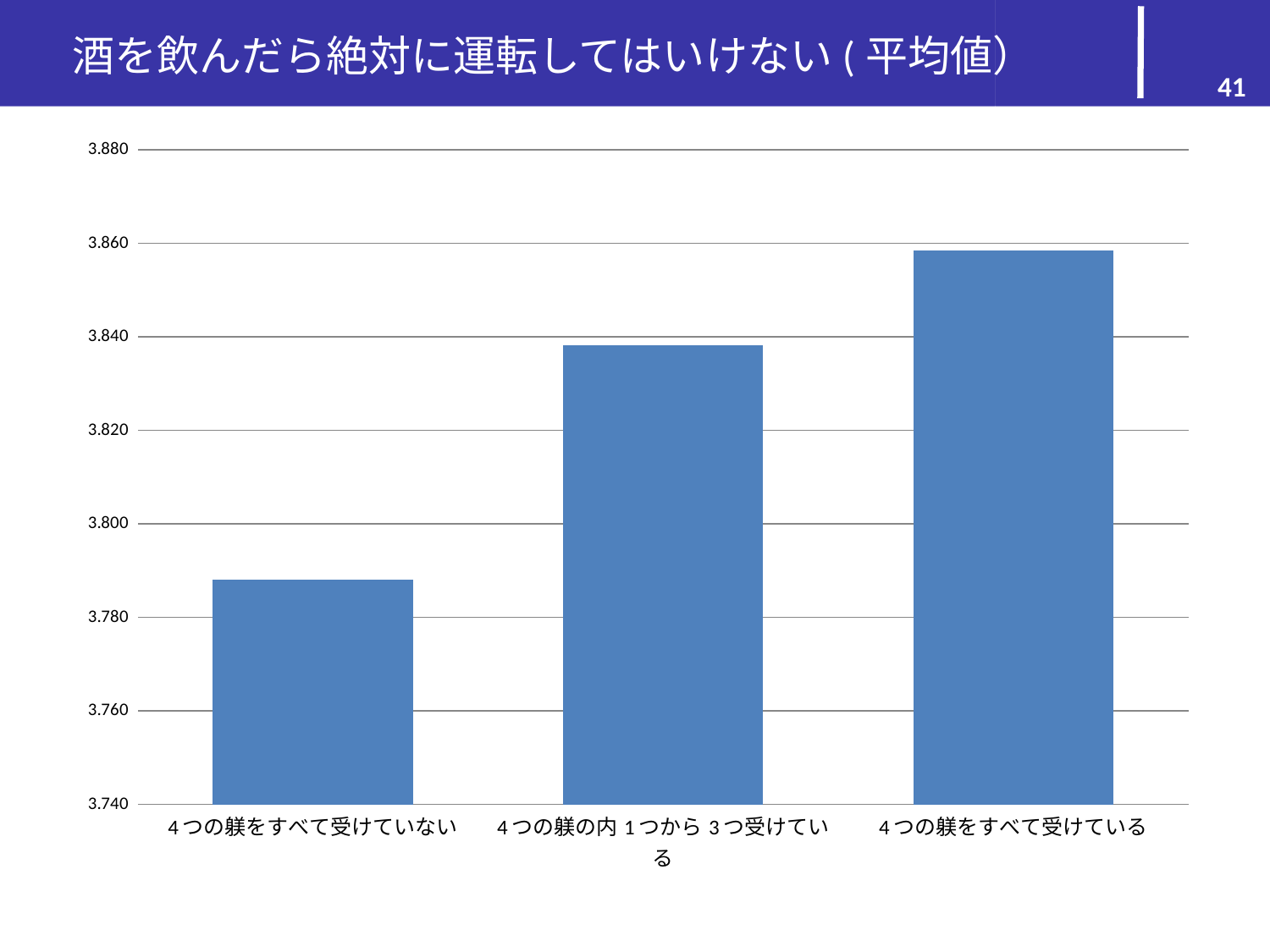
Which category has the lowest value? 4つの躾をすべて受けていない Is the value for 4つの躾をすべて受けていない greater or less than 3.800? less Which is larger, the value for 4つの躾をすべて受けていない or the value for 4つの躾の内1つから3つ受けている? 4つの躾の内1つから3つ受けている How many categories are plotted in the chart? 3 What is the title of the chart on the slide? 酒を飲んだら絶対に運転してはいけない（平均値） Which category has the highest value? 4つの躾をすべて受けている Do the values rise or fall from left to right across the categories? rise Is the value for 4つの躾をすべて受けている greater or less than 3.840? greater Is the value for 4つの躾の内1つから3つ受けている greater or less than 3.820? greater Which is larger, the value for 4つの躾の内1つから3つ受けている or the value for 4つの躾をすべて受けている? 4つの躾をすべて受けている What kind of chart is shown on the slide? bar chart